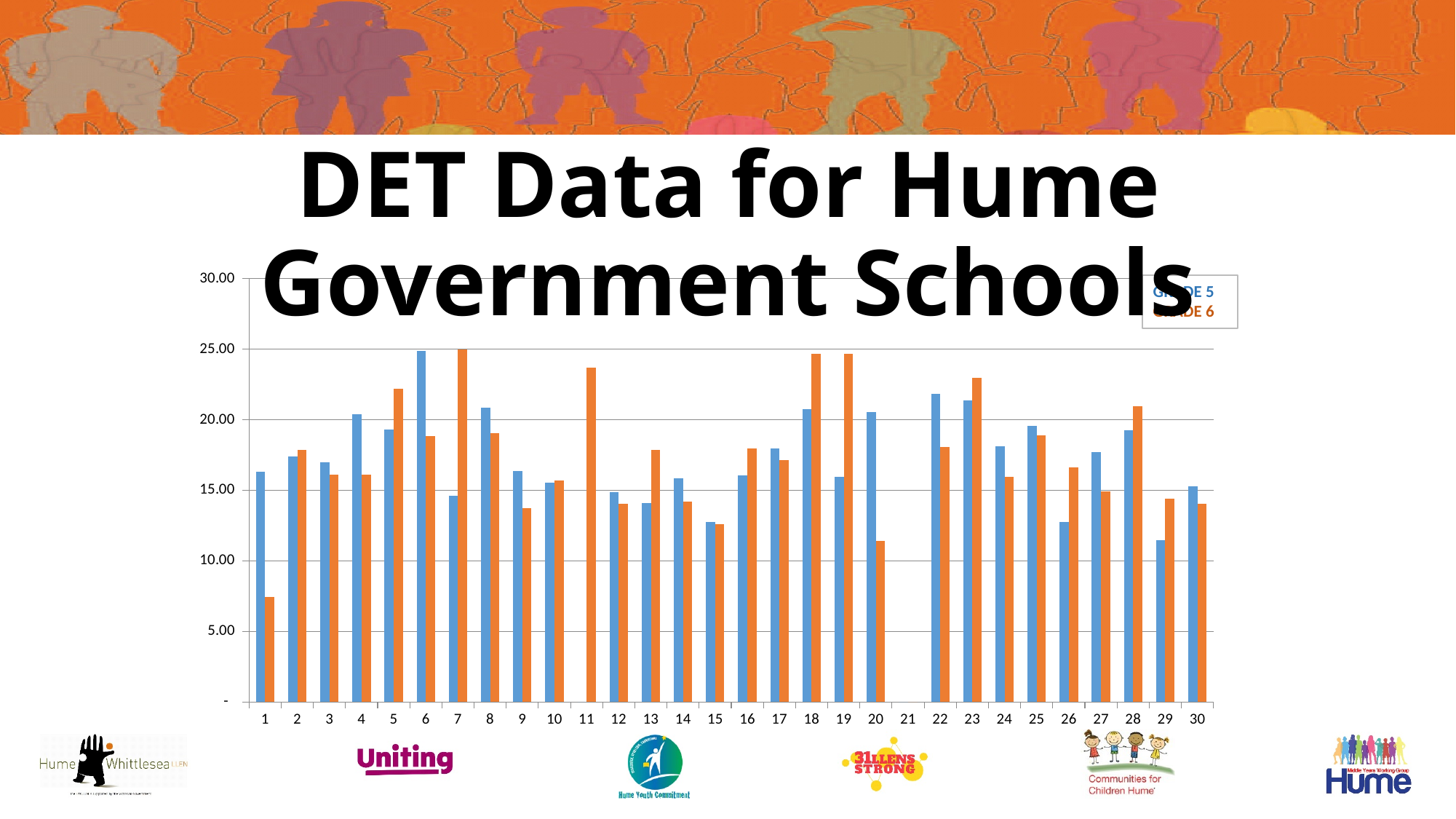
Is the Grade 5 value for category 6 greater or less than 20.00? greater Is the Grade 6 value for category 1 greater or less than 10.00? less Is the Grade 6 value for category 11 greater or less than 20.00? greater Which colour represents Grade 6 in the chart? Orange For category 7, which is larger: the Grade 5 value or the Grade 6 value? Grade 6 How many categories are labelled along the x axis? 30 For category 20, which is larger: the Grade 5 value or the Grade 6 value? Grade 5 Which category has the highest Grade 5 value? 6 How many series does the legend list? 2 What kind of chart is shown on the slide? Bar chart Which category has the lowest Grade 6 value? 1